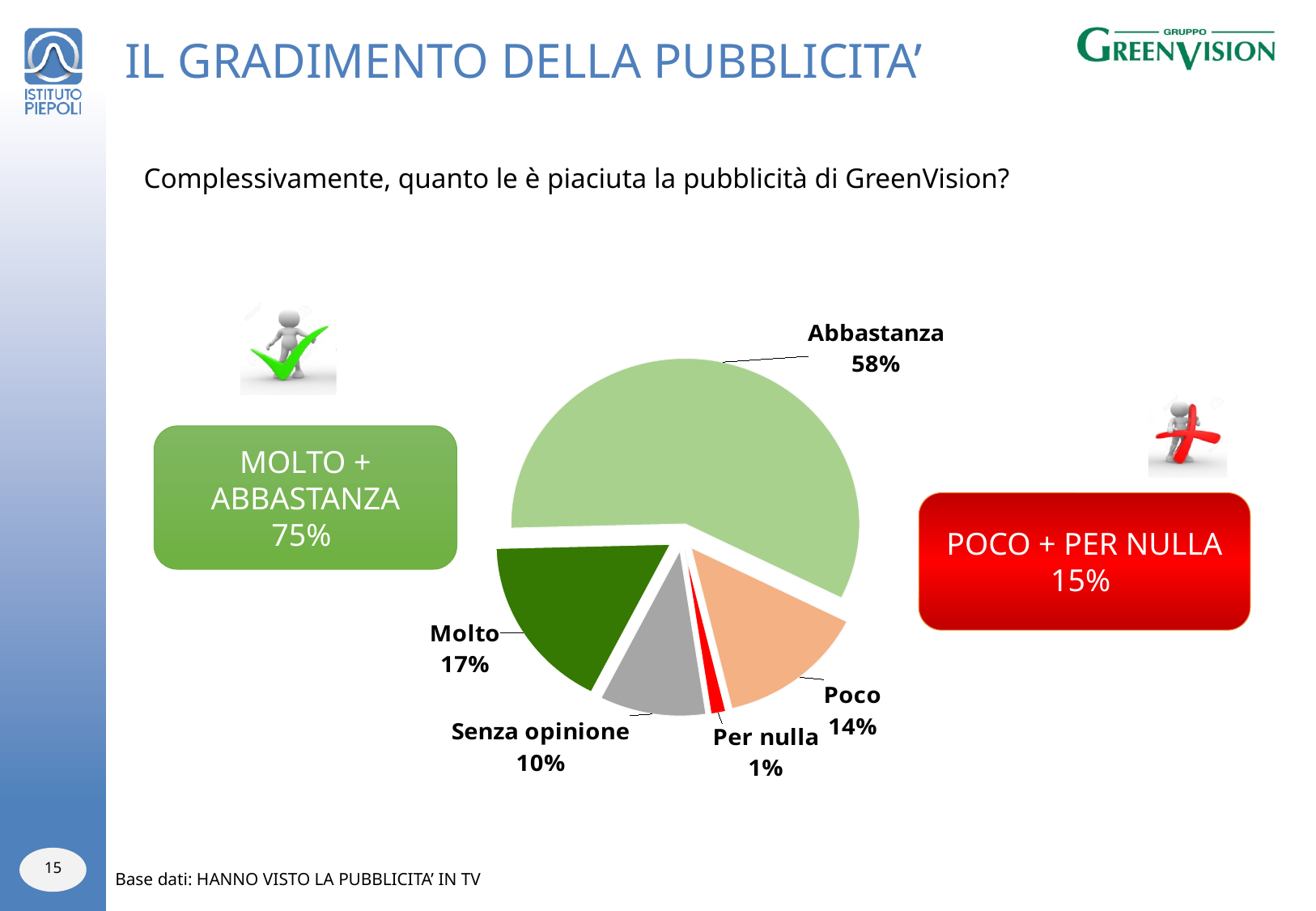
What kind of chart is shown on the slide? Pie chart Which category has the smallest slice of the pie? Per nulla What is the value for Senza opinione? 10% What is the difference between the Abbastanza and Molto values? 41% What share of the pie does the Abbastanza slice represent? 58% What is the value for Molto? 17% How many categories are shown in the pie chart? 5 Which category has the largest slice of the pie? Abbastanza What is the value for Per nulla? 1% Which is larger, Molto or Poco? Molto What is the value for Poco? 14% What colour is the Per nulla slice? Red